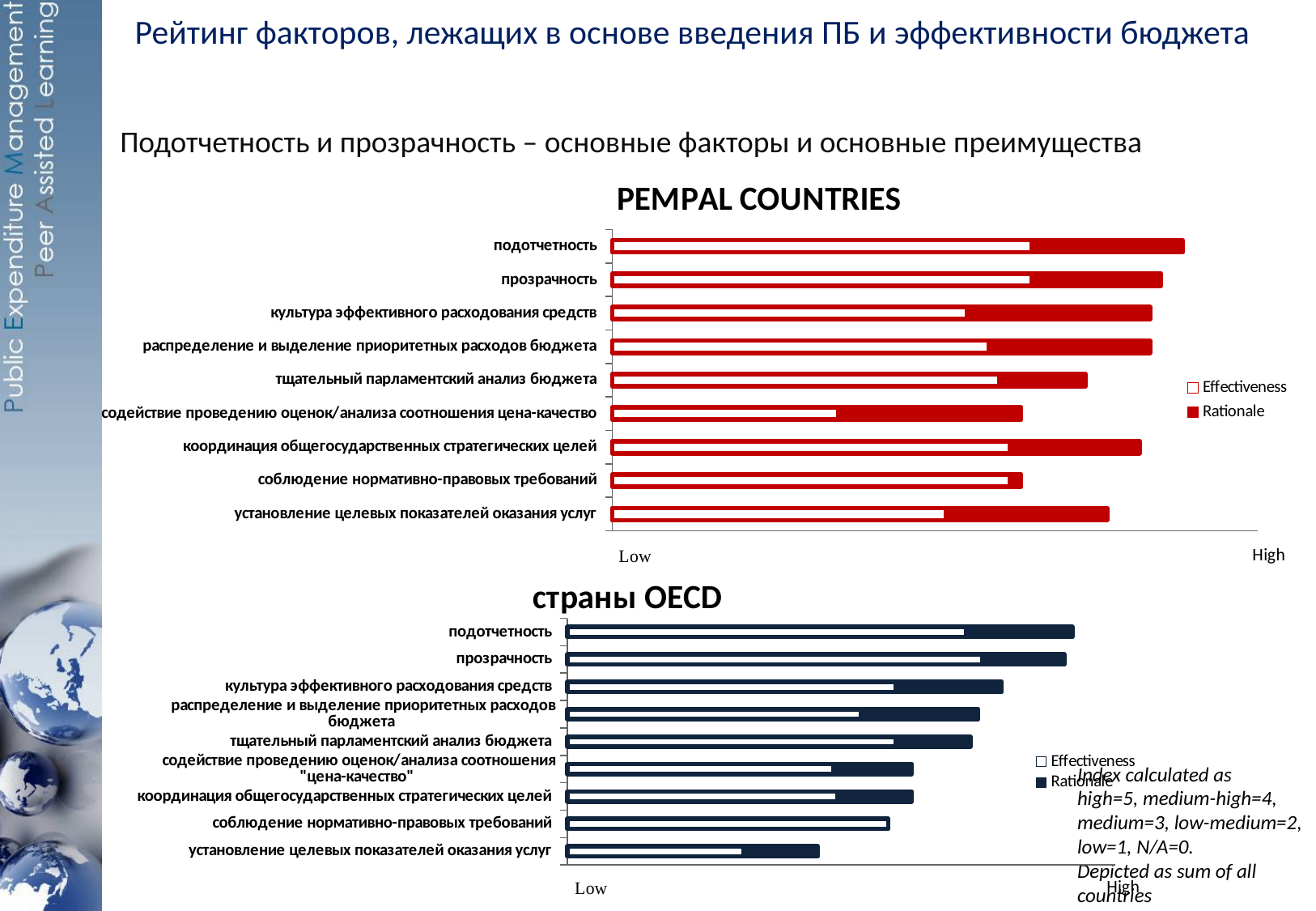
How many series does the legend of the PEMPAL COUNTRIES chart list? 2 In the страны OECD chart, which has the larger Effectiveness value: соблюдение нормативно-правовых требований or установление целевых показателей оказания услуг? соблюдение нормативно-правовых требований In the PEMPAL COUNTRIES chart, which has the larger Rationale value: подотчетность or установление целевых показателей оказания услуг? установление целевых показателей оказания услуг How many categories are shown in the страны OECD chart? 9 How many categories are shown in the PEMPAL COUNTRIES chart? 9 What colour are the Rationale bars in the PEMPAL COUNTRIES chart? red In the PEMPAL COUNTRIES chart, which category has the shortest Effectiveness bar? содействие проведению оценок/анализа соотношения цена-качество In the PEMPAL COUNTRIES chart, which has the larger Effectiveness value: культура эффективного расходования средств or содействие проведению оценок/анализа соотношения цена-качество? культура эффективного расходования средств In the страны OECD chart, which category has the shortest Rationale bar? соблюдение нормативно-правовых требований What kind of chart is the PEMPAL COUNTRIES chart? bar chart What are the two legend entries in the страны OECD chart? Effectiveness and Rationale